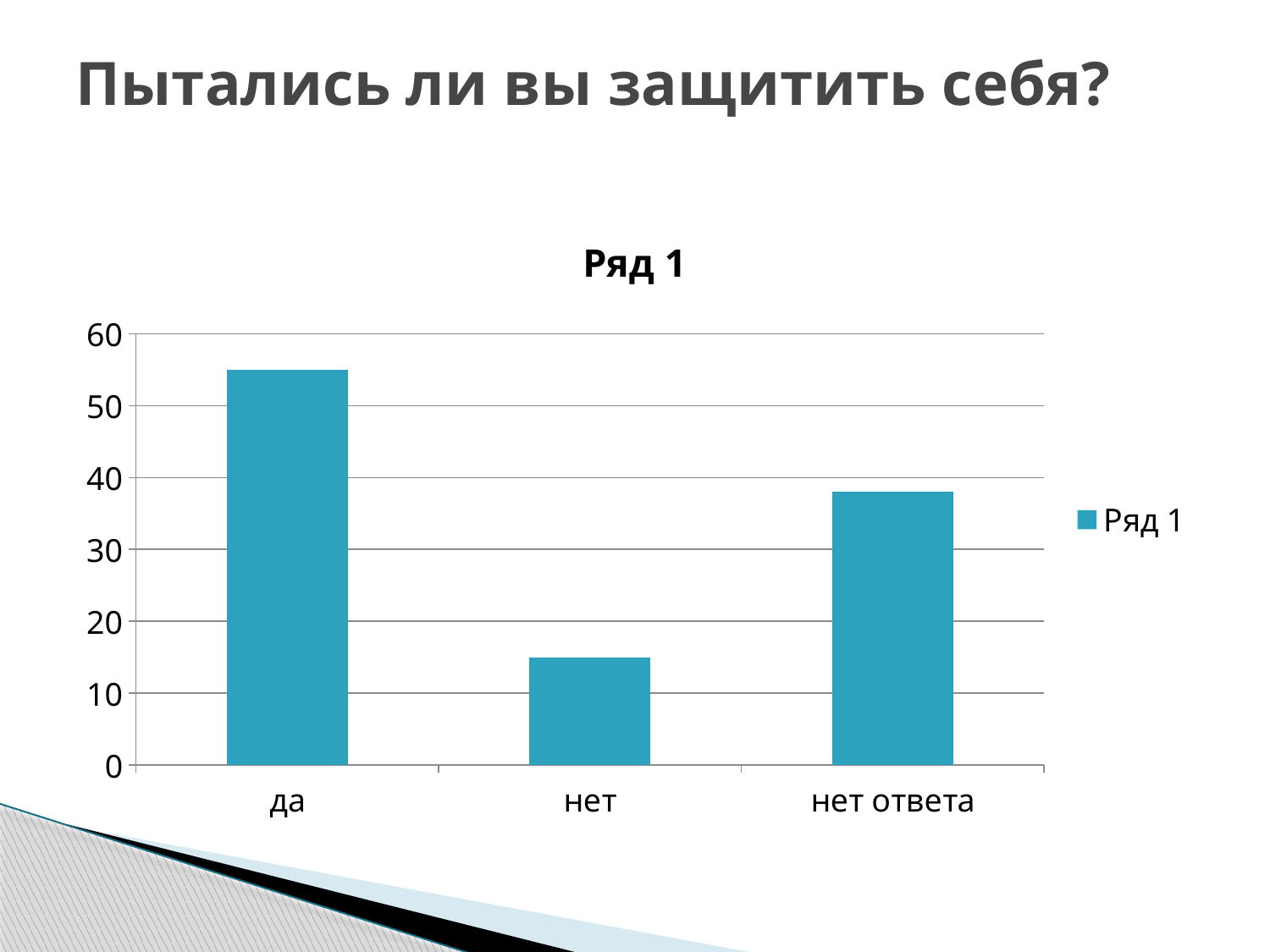
Is the value for "нет ответа" greater or less than 30? greater Which is larger, the value for "да" or the value for "нет ответа"? да Which is larger, the value for "нет" or the value for "нет ответа"? нет ответа Is the value for "нет" greater or less than 20? less How many categories are shown on the x axis of the chart? 3 What is the title of the chart? Ряд 1 How many series does the legend list? 1 What kind of chart is shown on the slide? bar chart Which category has the lowest bar? нет Is the value for "да" greater or less than 50? greater What is the name of the series shown in the legend? Ряд 1 Which category has the highest bar? да